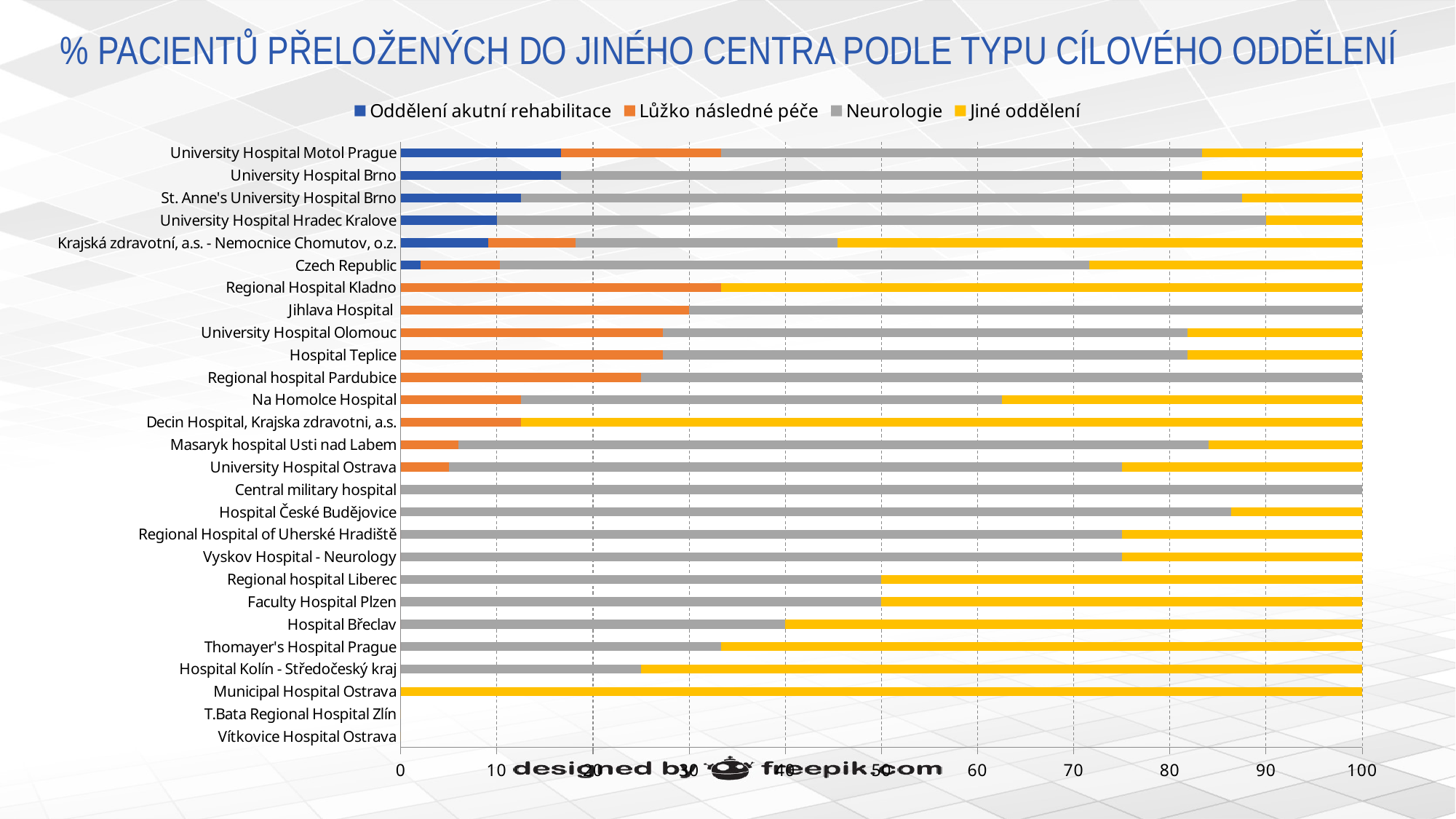
Which colour represents the Neurologie series in the legend? grey Which has the larger Oddělení akutní rehabilitace value, University Hospital Brno or St. Anne's University Hospital Brno? University Hospital Brno What is the value of Lůžko následné péče for Jihlava Hospital? 30 What is the value of Jiné oddělení for Municipal Hospital Ostrava? 100 What is the value of Neurologie for Regional hospital Liberec? 50 What is the value of Neurologie for Central military hospital? 100 Is the value of Oddělení akutní rehabilitace for University Hospital Motol Prague greater or less than 10? greater What is the value of Neurologie for Hospital Břeclav? 40 How many hospitals (categories) are listed on the vertical axis? 27 How many series does the legend list? 4 What is the value of Oddělení akutní rehabilitace for University Hospital Hradec Kralove? 10 What type of chart is shown on the slide? bar chart